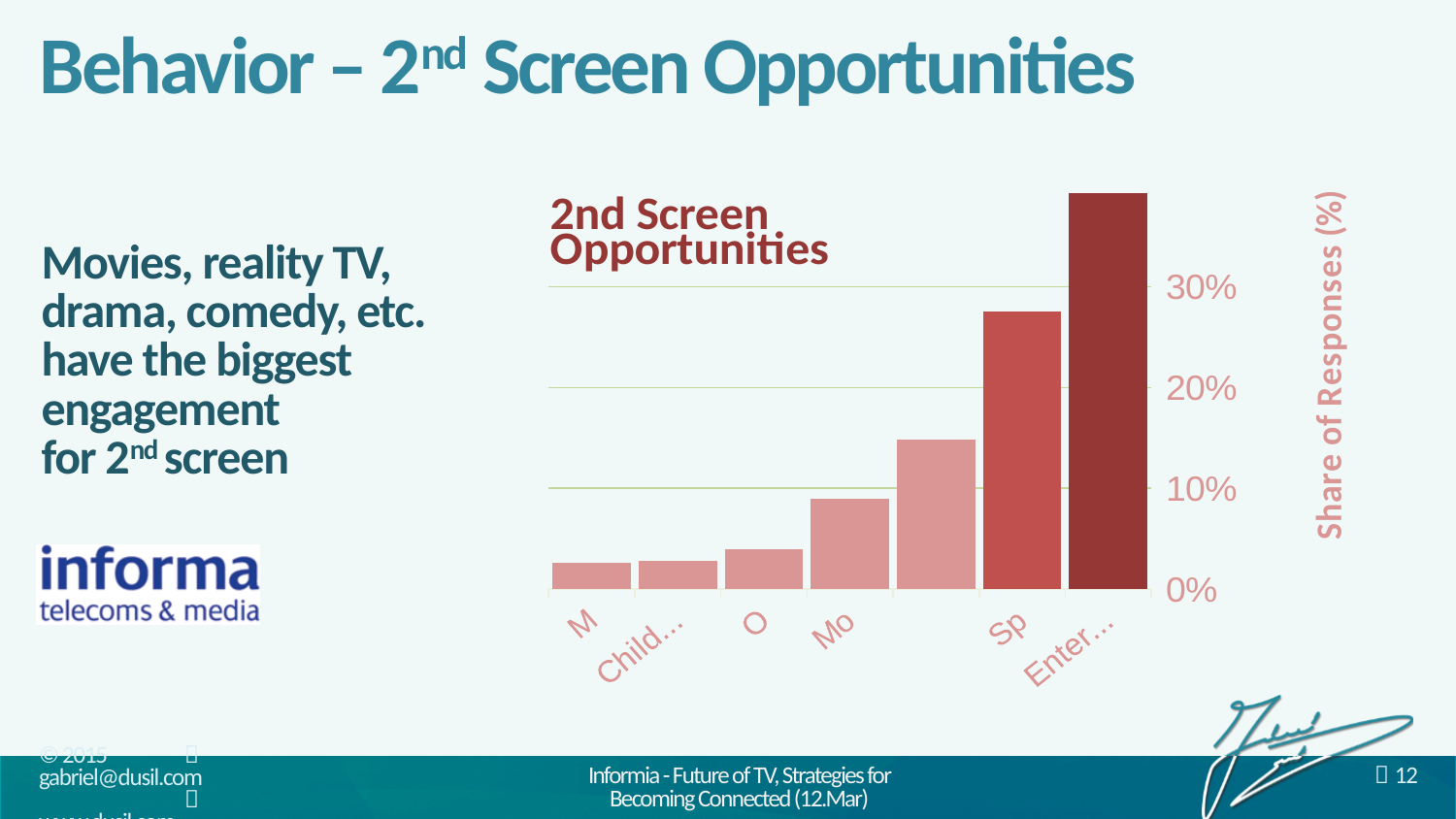
Is the value of the leftmost bar (M) greater or less than 10%? less Is the value of the bar labelled 'Sp' greater or less than 20%? greater What is the label of the vertical axis of the chart? Share of Responses (%) Is the value of the bar labelled 'Child...' greater or less than 10%? less Which bar is taller, the one labelled 'Sp' or the one labelled 'Mo'? Sp Do the bar values rise or fall from left to right across the chart? rise What is the title of the chart? 2nd Screen Opportunities How many bars are plotted in the chart? 7 Which bar has the highest value in the chart? the rightmost bar (Enter...) What kind of chart is shown on the slide? bar chart